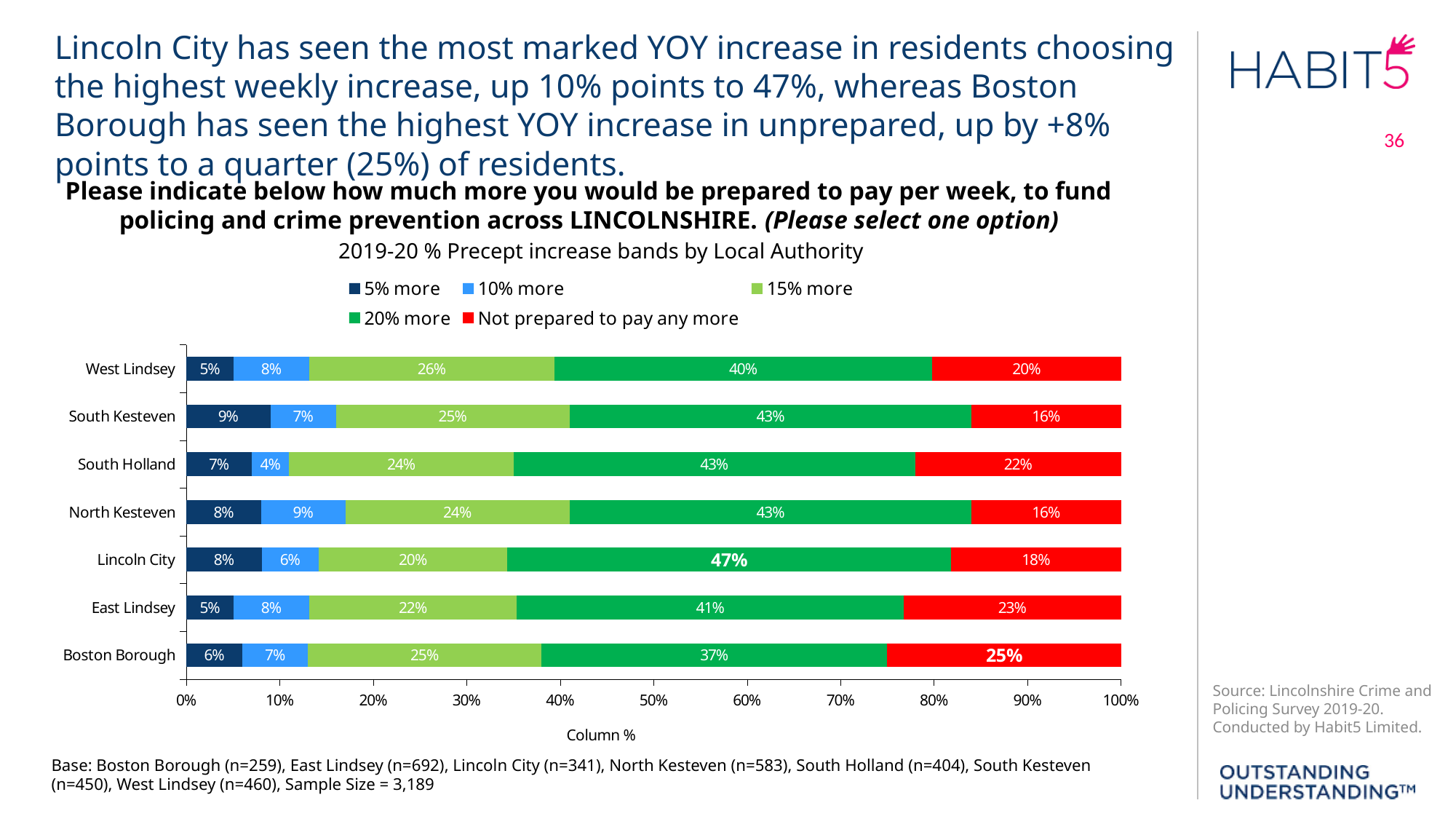
What is the value for '15% more' for West Lindsey? 26% What kind of chart is shown on the slide? Stacked bar chart What percentage of Lincoln City residents chose '20% more'? 47% Which is larger: the '10% more' value for North Kesteven or for South Holland? North Kesteven How many local authorities are shown on the chart? 7 Which colour represents 'Not prepared to pay any more' in the chart? Red What is the difference between the 'Not prepared to pay any more' values for Boston Borough and South Kesteven? 9% How many series does the legend list? 5 Which local authority has the lowest value for '20% more'? Boston Borough What percentage of Boston Borough residents were 'Not prepared to pay any more'? 25% What is the value for '5% more' for South Kesteven? 9% Which local authority has the highest value for '20% more'? Lincoln City